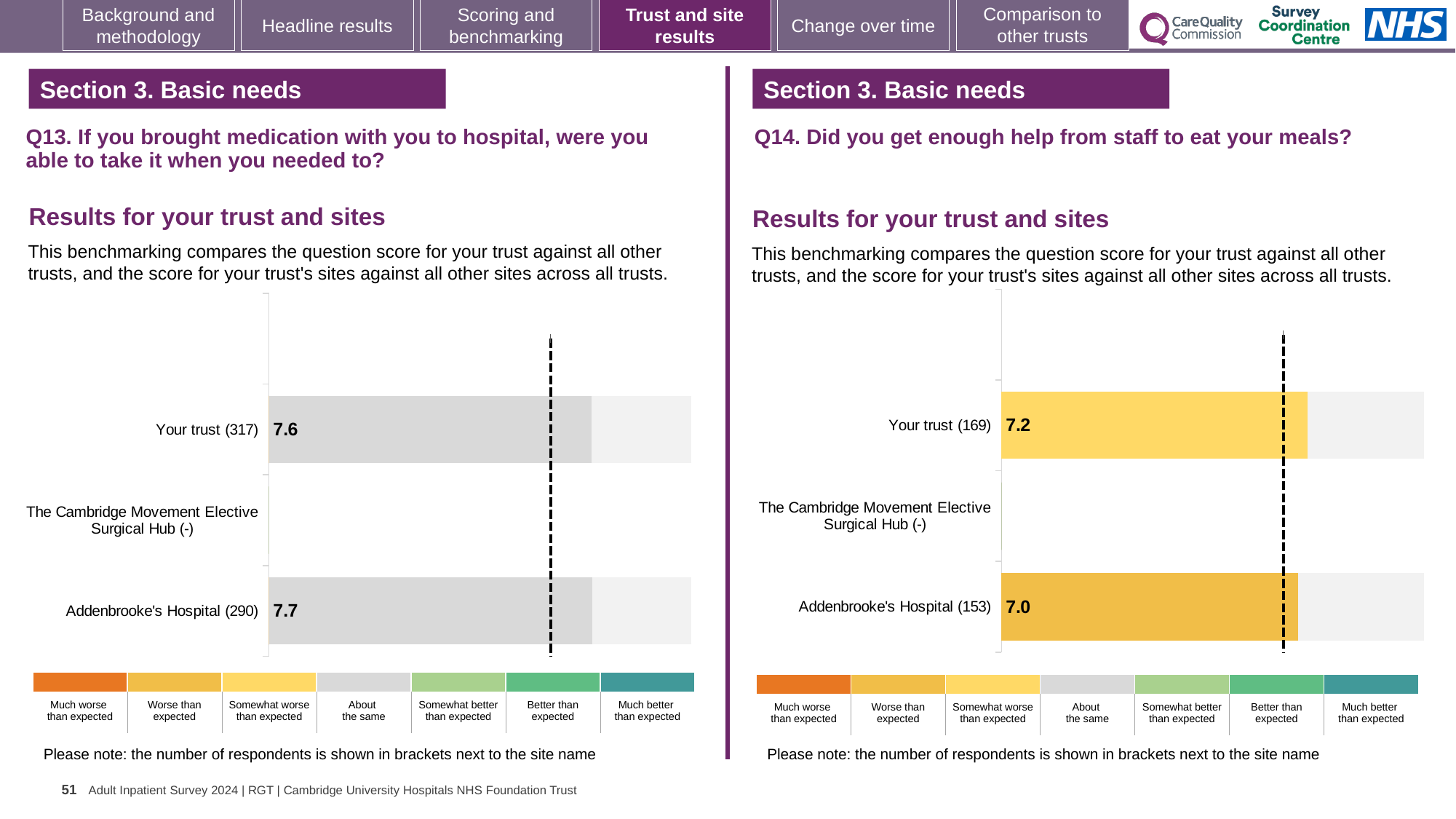
In the Q14 chart on the right, what is the score for Your trust? 7.2 In the Q13 chart on the left, what is the difference between the Addenbrooke's Hospital score and the Your trust score? 0.1 What kind of chart is used for the Q13 results on the left? Bar chart In the Q14 chart on the right, what is the difference between the Your trust score and the Addenbrooke's Hospital score? 0.2 In the Q13 chart on the left, which has the higher score, Your trust or Addenbrooke's Hospital? Addenbrooke's Hospital In the Q13 chart on the left, what is the score for Addenbrooke's Hospital? 7.7 In the Q14 chart on the right, which has the higher score, Your trust or Addenbrooke's Hospital? Your trust In the Q13 chart on the left, what is the score for Your trust? 7.6 How many respondents are shown in brackets for Your trust in the Q14 chart on the right? 169 In the Q14 chart on the right, what is the score for Addenbrooke's Hospital? 7.0 How many respondents are shown in brackets for Addenbrooke's Hospital in the Q13 chart on the left? 290 In the Q14 chart on the right, which site has no bar plotted? The Cambridge Movement Elective Surgical Hub